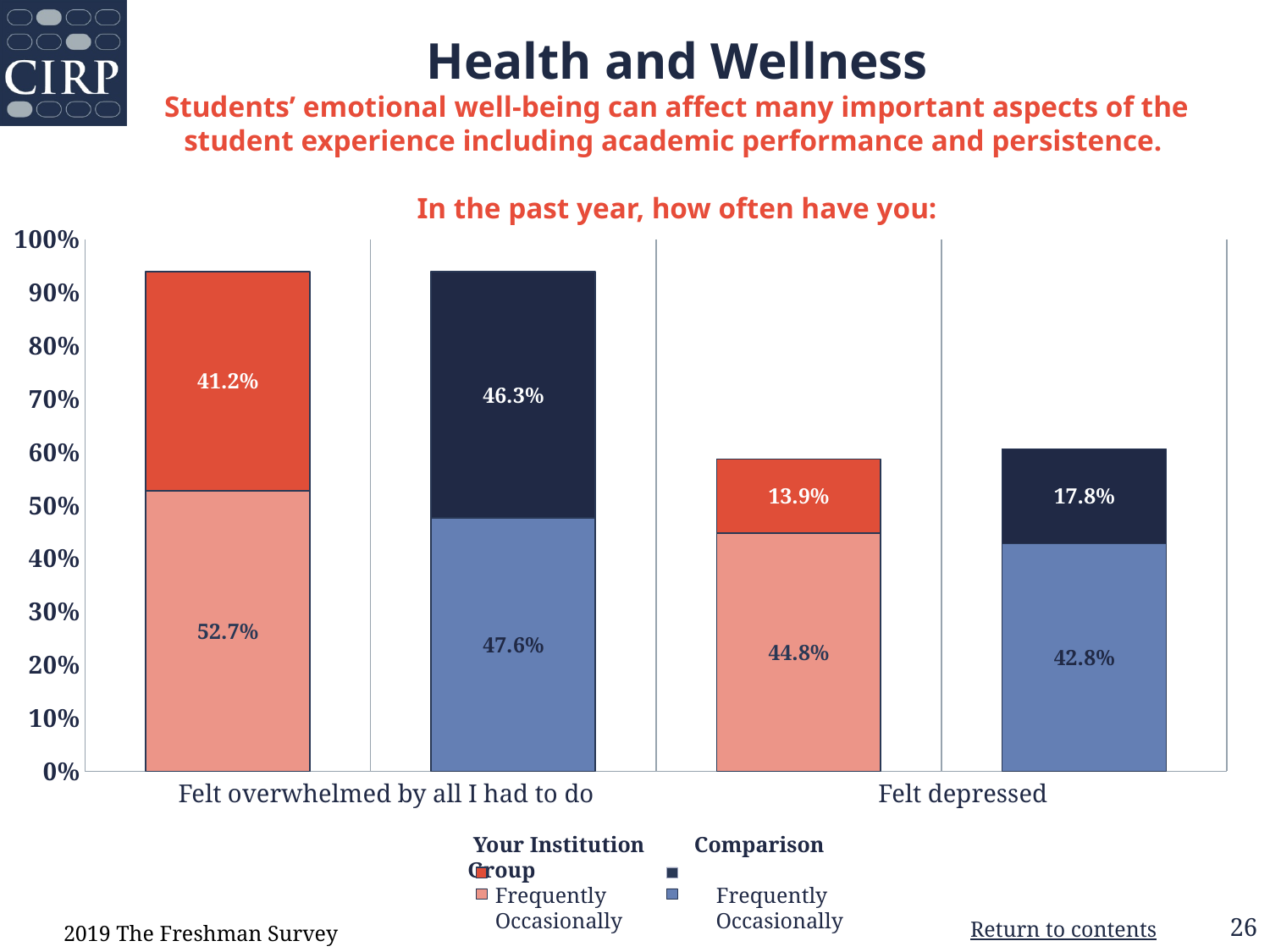
What type of chart is shown on the slide? Stacked bar chart Which is larger for 'Felt depressed': the 'frequently' percentage for Your Institution or for the Comparison Group? Comparison Group What percentage of students at Your Institution reported occasionally feeling overwhelmed by all they had to do? 52.7% Which of the two survey items has the lowest 'frequently' percentage for Your Institution? Felt depressed What is the combined percentage (frequently plus occasionally) of the Comparison Group who felt overwhelmed by all they had to do? 93.9% Is the total stacked bar for Your Institution on 'Felt depressed' greater or less than 60%? less How much higher is the Comparison Group's 'frequently' percentage than Your Institution's for feeling overwhelmed by all they had to do? 5.1 percentage points How many survey items (categories) are shown on the x axis of the chart? 2 What percentage of the Comparison Group reported frequently feeling depressed? 17.8% What is the combined percentage (frequently plus occasionally) of students at Your Institution who felt depressed? 58.7% What percentage of the Comparison Group reported occasionally feeling depressed? 42.8% What percentage of students at Your Institution reported frequently feeling overwhelmed by all they had to do? 41.2%